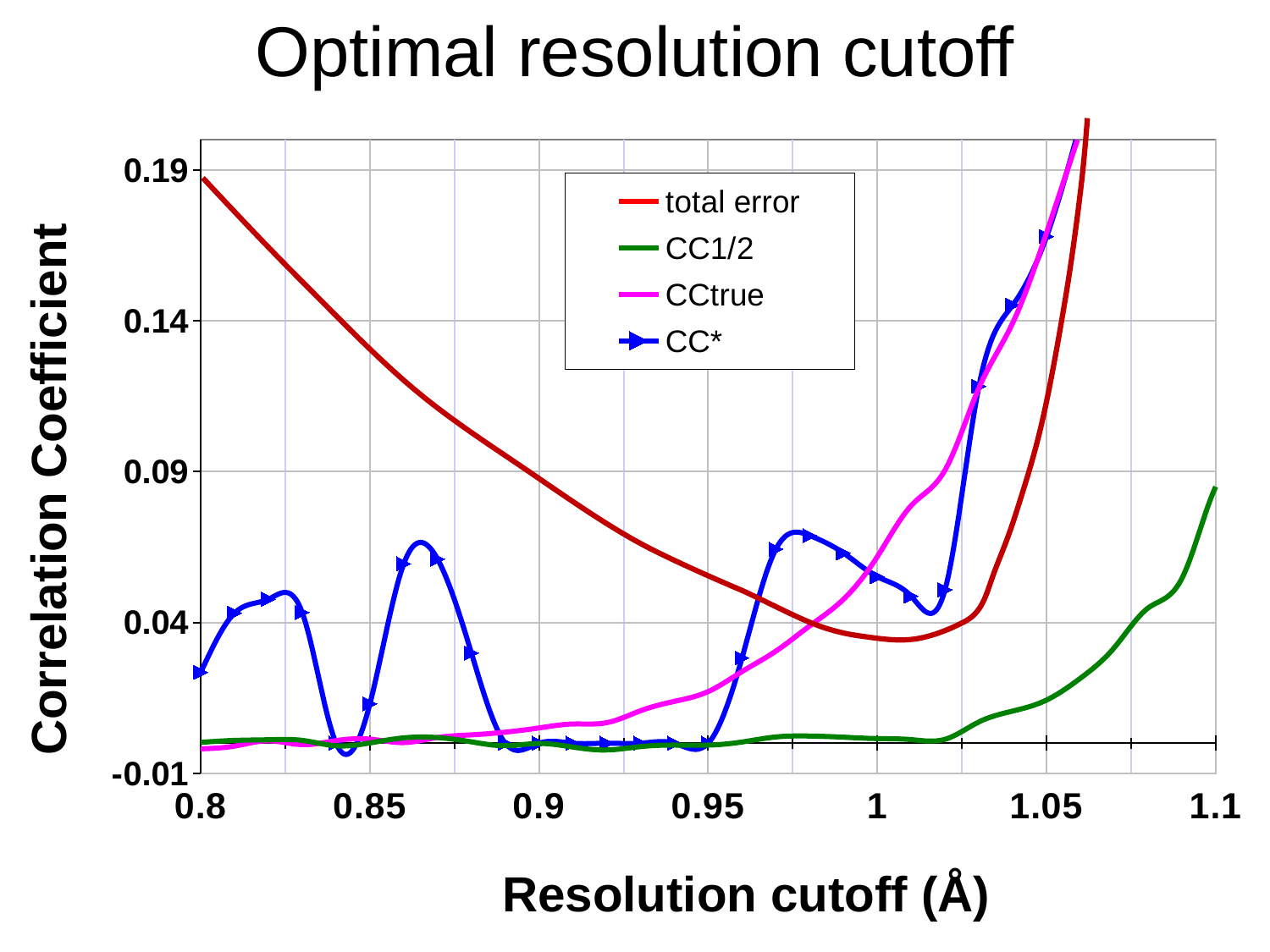
Is the value of the CCtrue series at a resolution cutoff of 1.05 greater or less than 0.14? greater What is the label of the x axis? Resolution cutoff (Å) At a resolution cutoff of 0.9, which series has the larger value, total error or CC1/2? total error What kind of chart is shown on the slide? line chart What is the title of the chart? Optimal resolution cutoff Is the value of the total error series at a resolution cutoff of 0.8 greater or less than 0.14? greater Is the value of the CC1/2 series at a resolution cutoff of 0.9 greater or less than 0.04? less At a resolution cutoff of 1.05, which series has the larger value, total error or CCtrue? CCtrue Which series has the highest value at a resolution cutoff of 0.8? total error Does the total error series rise or fall as the resolution cutoff increases from 0.8 to 1.0? fall How many series does the legend list? 4